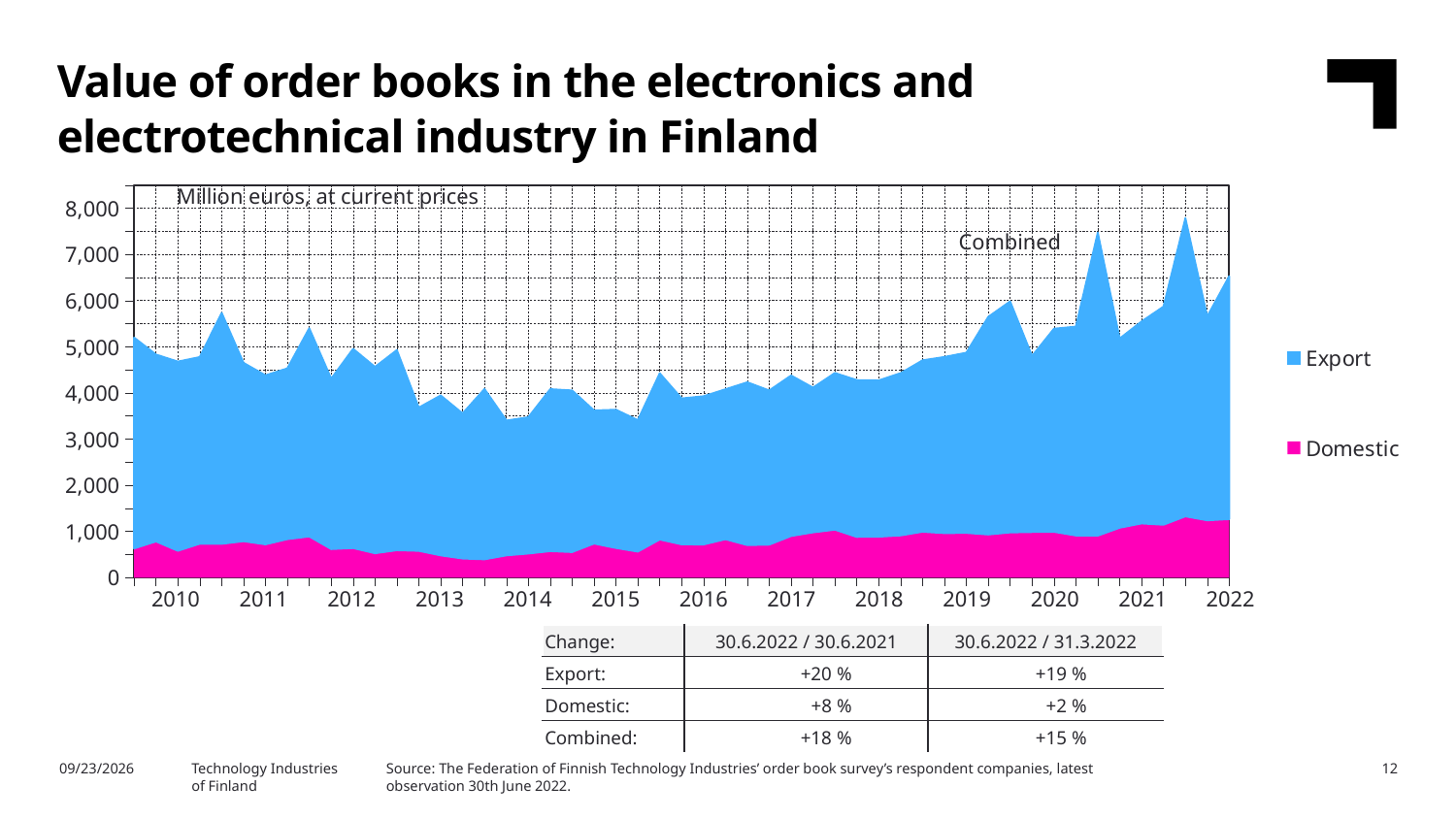
Is the combined value at the 2022 end of the chart greater or less than 6,000? greater How many years are labelled on the x axis of the chart? 13 Is the highest combined peak on the chart greater or less than 7,000? greater What unit is stated for the values on the chart? Million euros, at current prices What type of chart is shown on the slide? Area chart How many series does the chart legend list? 2 Does the combined value generally rise or fall from 2019 to 2022? rise Which series is larger at the 2022 end of the chart, Export or Domestic? Export Which series accounts for the larger share of the combined order book value throughout the chart? Export Is the combined value at the start of 2014 greater or less than 4,000? less What are the two series named in the chart legend? Export and Domestic